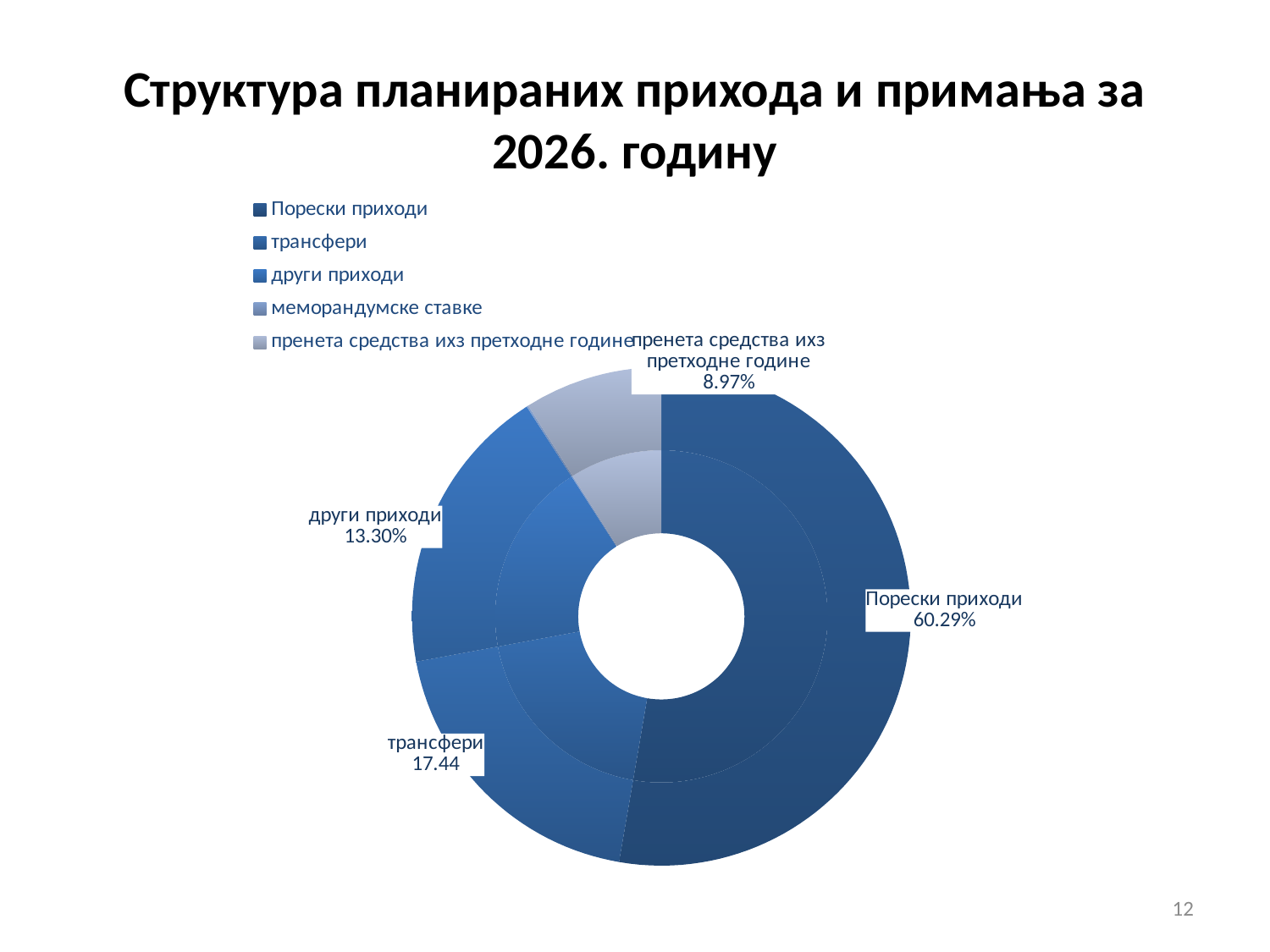
What is the difference between the shares for други приходи and пренета средства ихз претходне године? 4.33% How many entries does the legend list? 5 Which is larger, the share for други приходи or the share for пренета средства ихз претходне године? други приходи What share of the chart is labelled for Порески приходи? 60.29% What value is shown for трансфери on the chart? 17.44 Which is larger, the value for трансфери or the value for други приходи? трансфери What is the title of the slide containing the chart? Структура планираних прихода и примања за 2026. годину What percentage is shown for други приходи? 13.30% Which category has the largest share of the chart? Порески приходи What percentage is shown for пренета средства ихз претходне године? 8.97% Which legend entry is listed first? Порески приходи What kind of chart is shown on the slide? Doughnut (pie) chart